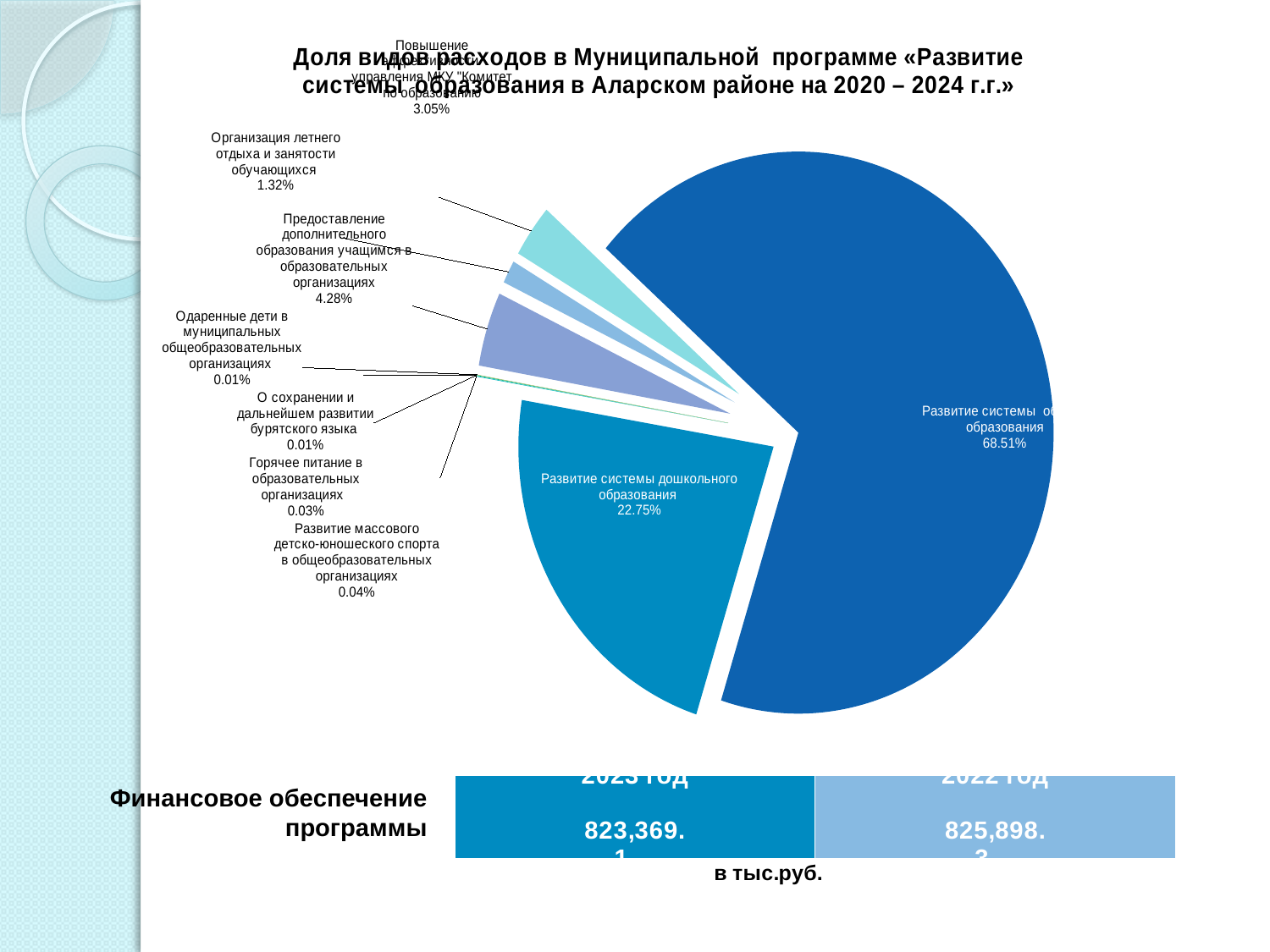
What is the share of the largest slice in the pie chart? 68.51% How many slices does the pie chart have? 9 What is the title of the chart on the slide? Доля видов расходов в Муниципальной программе «Развитие системы образования в Аларском районе на 2020 – 2024 г.г.» What percentage is shown for «Развитие массового детско-юношеского спорта в общеобразовательных организациях»? 0.04% What is the smallest percentage value shown on the pie chart? 0.01% What share of expenses does «Развитие системы дошкольного образования» have in the pie chart? 22.75% What kind of chart is shown on the slide? pie chart What percentage is shown for «Горячее питание в образовательных организациях»? 0.03% What percentage is shown for «Организация летнего отдыха и занятости обучающихся»? 1.32% Which has a larger share: «Горячее питание в образовательных организациях» or «Развитие массового детско-юношеского спорта в общеобразовательных организациях»? Развитие массового детско-юношеского спорта в общеобразовательных организациях What percentage is shown for «Предоставление дополнительного образования учащимся в образовательных организациях»? 4.28% What is the difference between the share of «Развитие системы дошкольного образования» and «Предоставление дополнительного образования учащимся в образовательных организациях»? 18.47%